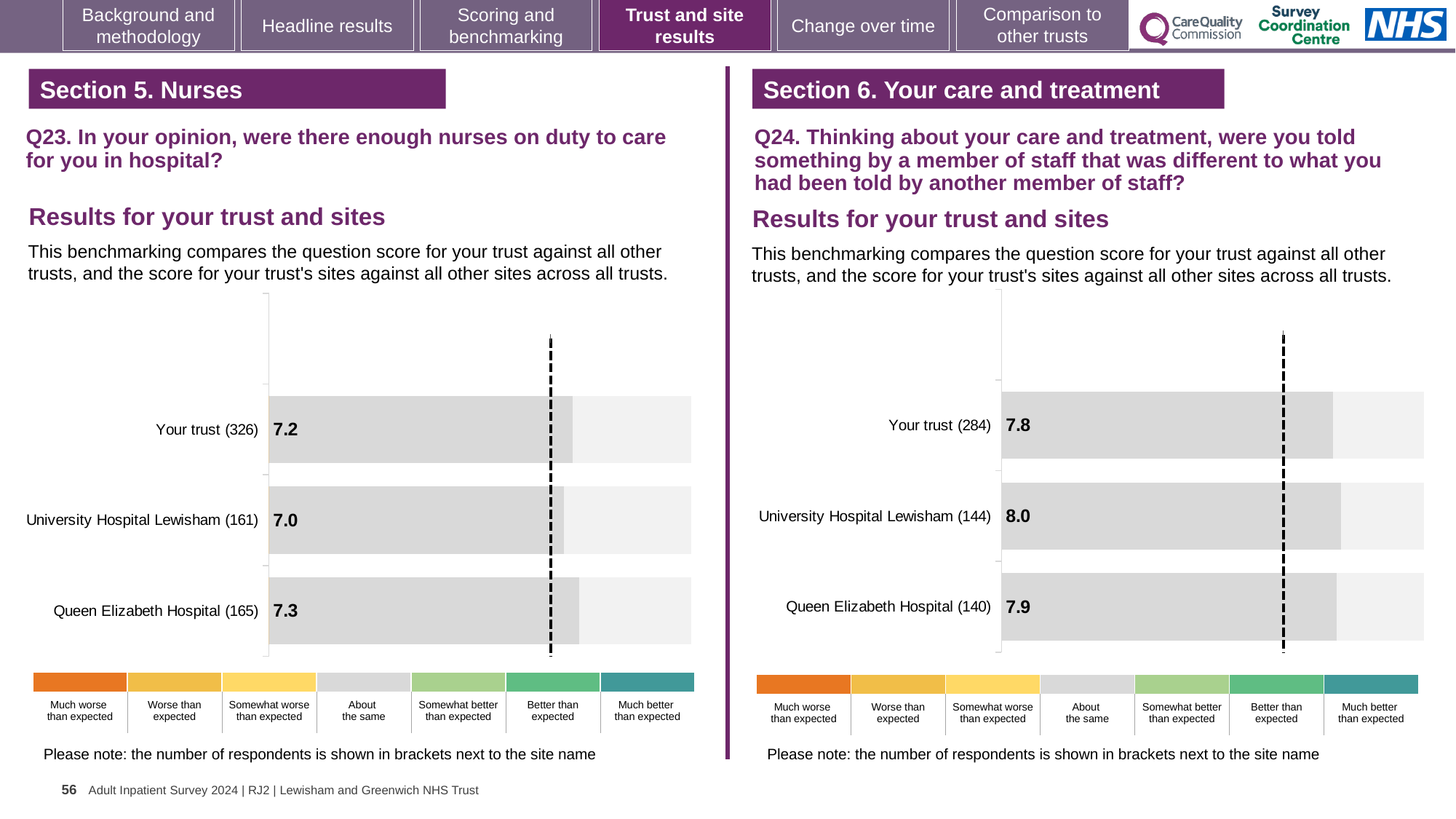
How many bars are plotted on the Q23 chart (left)? 3 On the Q23 chart (left), what is the score for Your trust (326)? 7.2 On the Q24 chart (right), which is larger: the score for University Hospital Lewisham (144) or Your trust (284)? University Hospital Lewisham (144) On the Q24 chart (right), what is the score for Your trust (284)? 7.8 What kind of chart is used on the Q24 chart (right)? Bar chart On the Q24 chart (right), what is the score for Queen Elizabeth Hospital (140)? 7.9 On the Q24 chart (right), what is the difference between the scores for University Hospital Lewisham (144) and Your trust (284)? 0.2 On the Q24 chart (right), which site or trust has the highest score? University Hospital Lewisham (144) On the Q23 chart (left), which site or trust has the lowest score? University Hospital Lewisham (161) On the Q23 chart (left), what is the difference between the scores for Queen Elizabeth Hospital (165) and University Hospital Lewisham (161)? 0.3 On the Q23 chart (left), which site or trust has the highest score? Queen Elizabeth Hospital (165) On the Q23 chart (left), what is the score for University Hospital Lewisham (161)? 7.0